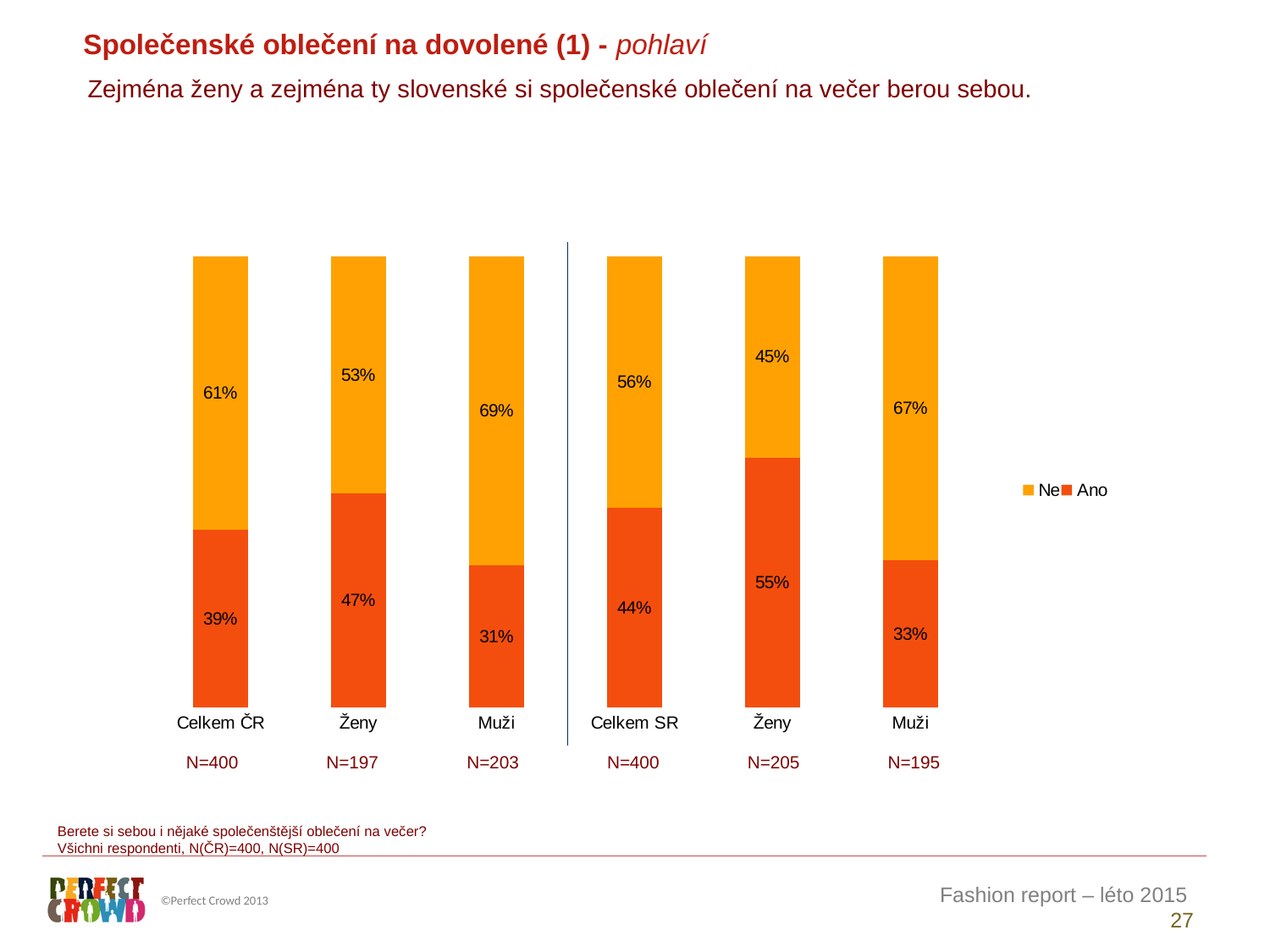
What is the "Ne" value for Muži in the ČR group (left half of the chart)? 69% Which category has the highest "Ano" value? Ženy (SR) What is the "Ano" value for Celkem ČR? 39% What is the total of the stacked bar for Muži in the SR group? 100% Which is larger: the "Ano" value for Celkem ČR or for Celkem SR? Celkem SR How many bars (categories) are shown in the chart? 6 Which category has the lowest "Ano" value? Muži (ČR) What is the "Ne" value for Celkem SR? 56% How many series does the legend list? 2 What is the "Ano" value for Ženy in the SR group (right half of the chart)? 55% What type of chart is shown on the slide? Stacked bar chart What is the difference between the "Ano" values for Ženy and Muži in the ČR group? 16%